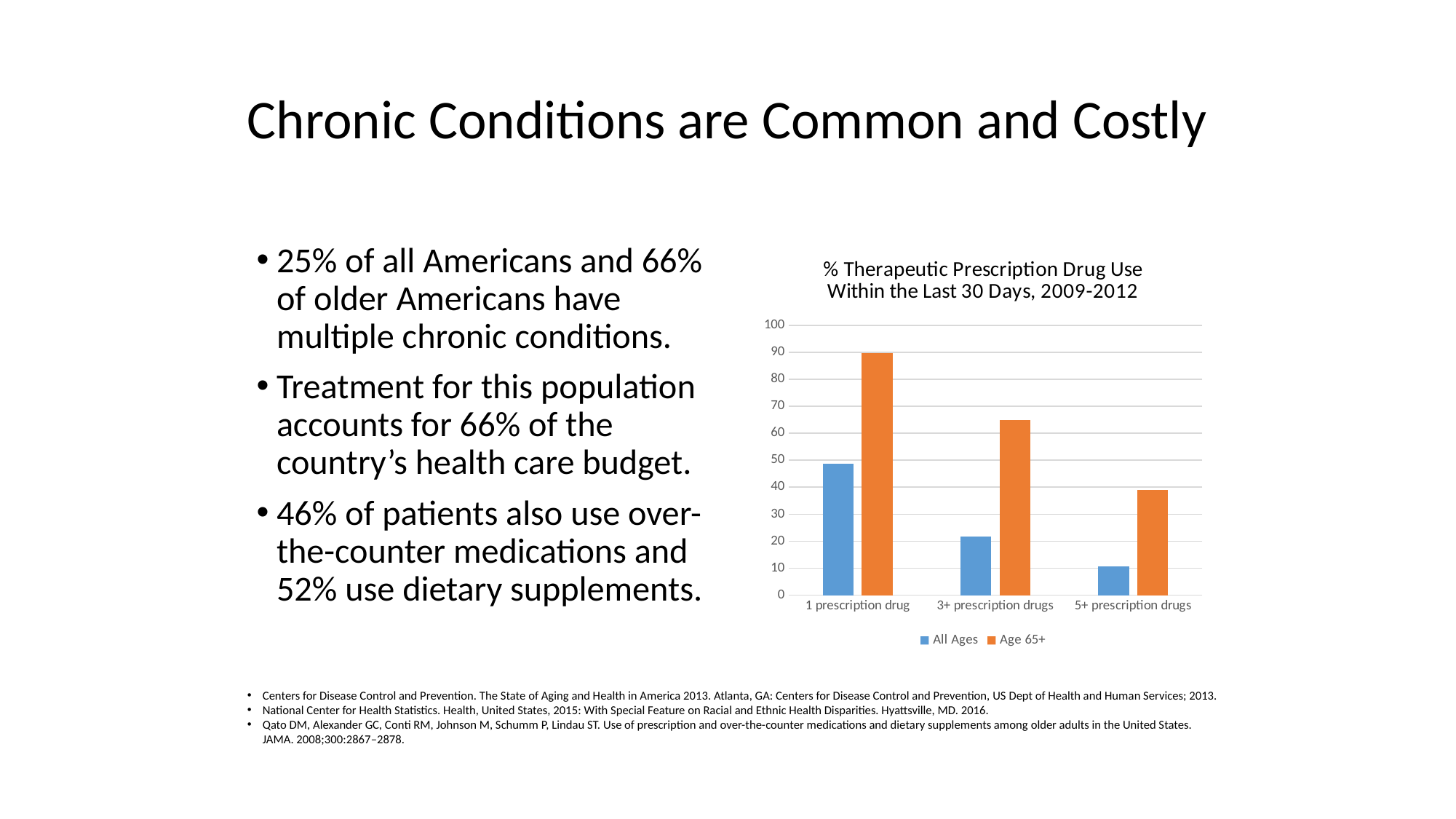
For 3+ prescription drugs, which series has the larger value, All Ages or Age 65+? Age 65+ What kind of chart is shown on the slide? bar chart Which category has the lowest value for the All Ages series? 5+ prescription drugs Which colour represents the Age 65+ series in the chart? orange Is the Age 65+ value for 5+ prescription drugs greater or less than 30? greater How many series does the chart's legend list? 2 Is the All Ages value for 5+ prescription drugs greater or less than 20? less How many categories are shown on the x axis of the chart? 3 Do the Age 65+ values rise or fall moving from 1 prescription drug to 5+ prescription drugs? fall Which category has the highest value for the Age 65+ series? 1 prescription drug Is the Age 65+ value for 1 prescription drug greater or less than 80? greater What is the title of the chart? % Therapeutic Prescription Drug Use Within the Last 30 Days, 2009-2012